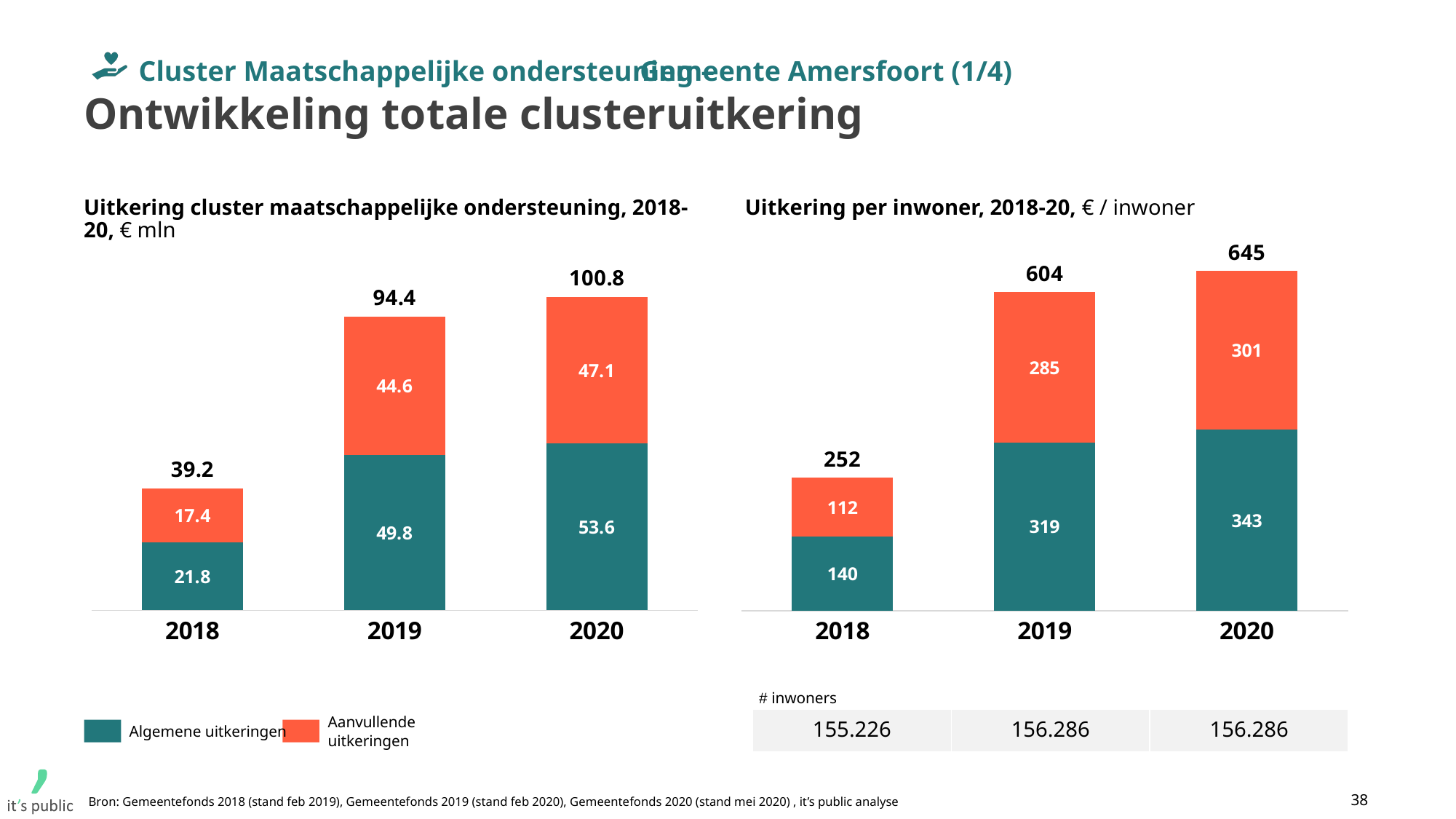
In the right chart (Uitkering per inwoner), what is the total of the stacked bar for 2020? 645 In the right chart (Uitkering per inwoner), is the Algemene uitkeringen value for 2019 larger or smaller than the Aanvullende uitkeringen value for 2019? larger In the left chart (Uitkering cluster maatschappelijke ondersteuning), what is the value of Aanvullende uitkeringen for 2020? 47.1 In the right chart (Uitkering per inwoner), do the totals rise or fall from 2018 to 2020? rise In the right chart (Uitkering per inwoner), which year has the lowest total? 2018 What kind of chart is the left chart (Uitkering cluster maatschappelijke ondersteuning)? stacked bar chart In the left chart (Uitkering cluster maatschappelijke ondersteuning), what is the value of Algemene uitkeringen for 2019? 49.8 In the right chart (Uitkering per inwoner), what is the value of Aanvullende uitkeringen for 2019? 285 In the left chart (Uitkering cluster maatschappelijke ondersteuning), what is the difference between the Algemene uitkeringen values for 2020 and 2018? 31.8 In the left chart (Uitkering cluster maatschappelijke ondersteuning), which year has the highest total? 2020 How many series does the legend list for the charts on this slide? 2 In the left chart (Uitkering cluster maatschappelijke ondersteuning), what is the total of the stacked bar for 2018? 39.2